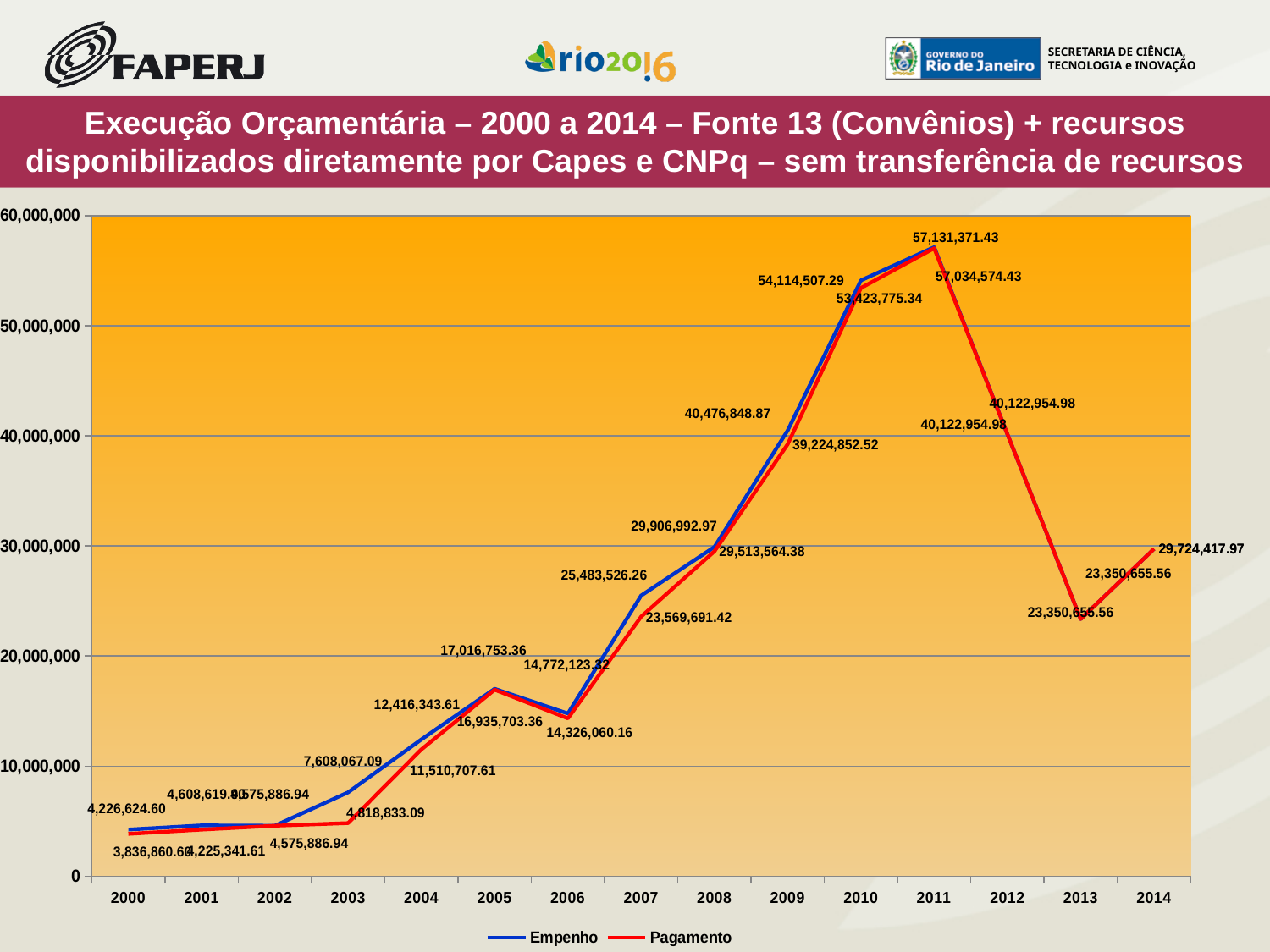
Do the values rise or fall from 2011 to 2013? fall In which year does the Empenho series reach its highest value? 2011 How many series does the legend list? 2 In 2009, which is larger, Empenho or Pagamento? Empenho What kind of chart is shown on the slide? Line chart How many years are plotted along the x axis? 15 In which year is the Pagamento value lowest? 2000 Is the value for 2013 greater or less than 30,000,000? less What is the Pagamento value for 2010? 53,423,775.34 What is the Pagamento value for 2003? 4,818,833.09 What is the Empenho value for 2011? 57,131,371.43 What is the difference between Empenho and Pagamento in 2011? 96,797.00